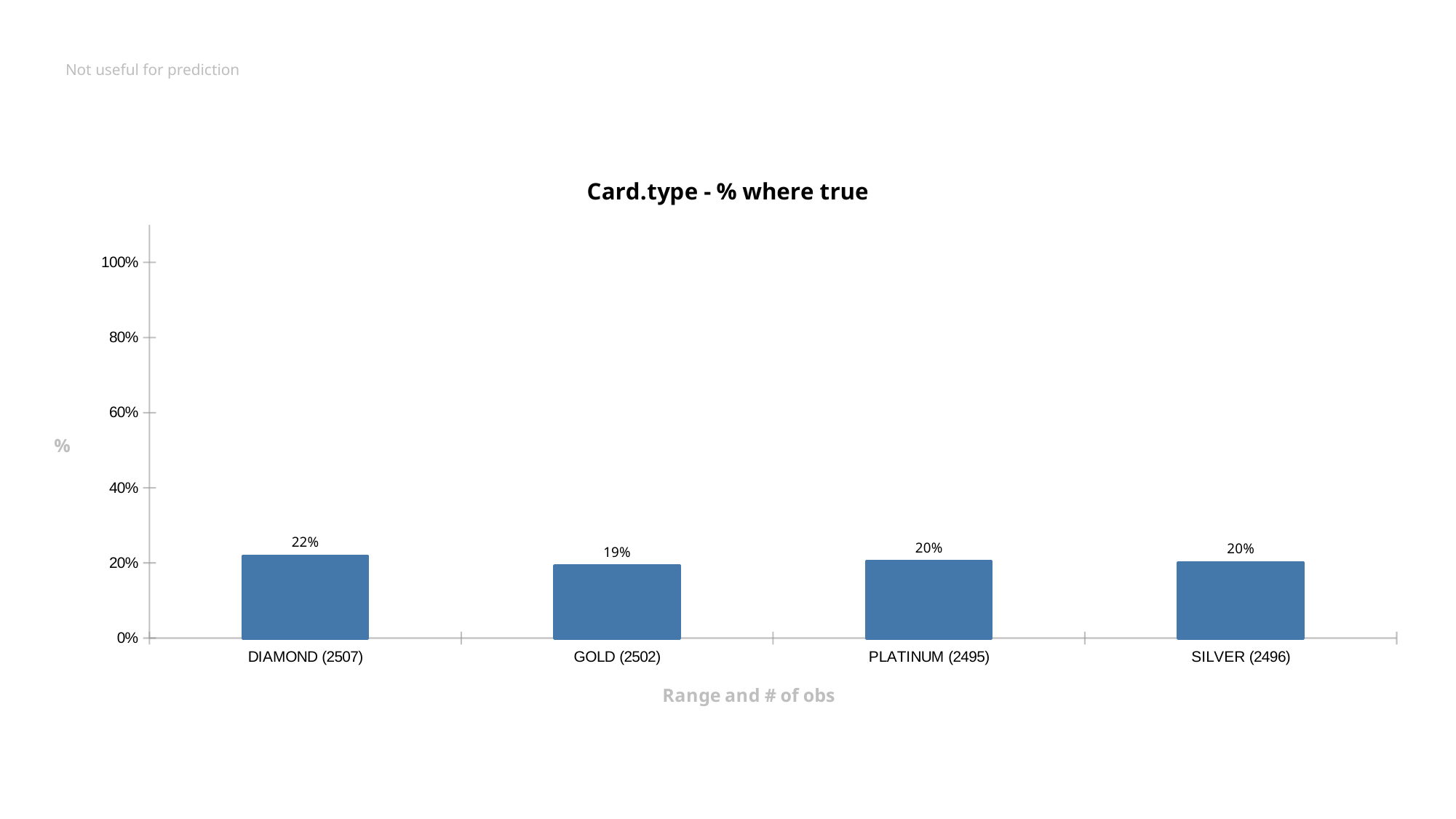
Is the value for GOLD (2502) greater or less than 40%? less Which category has the lowest value? GOLD (2502) What is the value for SILVER (2496)? 20% What is the value for PLATINUM (2495)? 20% What is the title of the chart? Card.type - % where true Which category has the highest value? DIAMOND (2507) What kind of chart is shown on the slide? bar chart How many categories are shown on the x axis? 4 Which is larger, the value for DIAMOND (2507) or the value for PLATINUM (2495)? DIAMOND (2507) What is the value for DIAMOND (2507)? 22% What is the difference between the values for DIAMOND (2507) and GOLD (2502)? 3% What is the value for GOLD (2502)? 19%